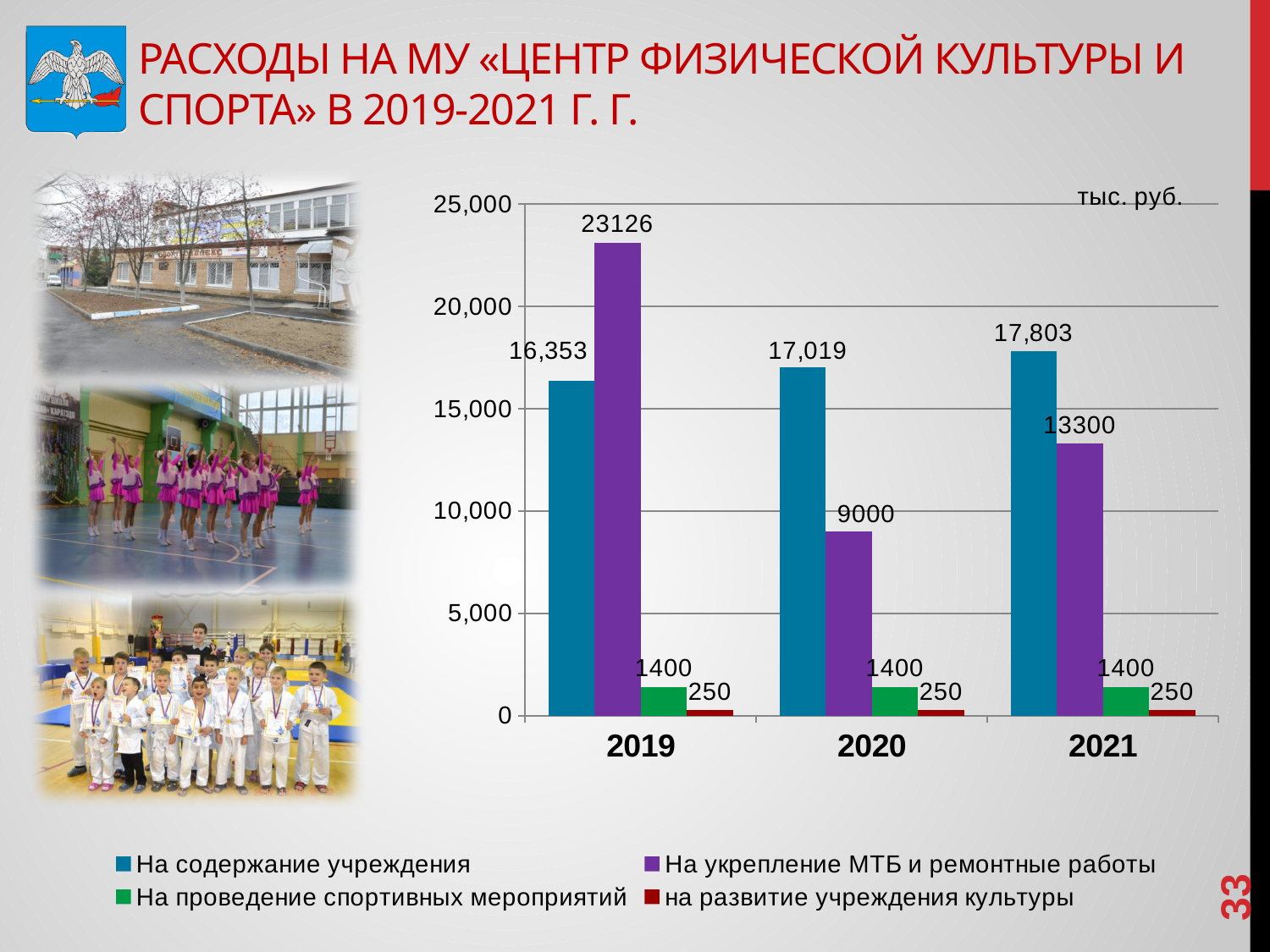
What is the value for «На содержание учреждения» in 2019? 16,353 What is the value for «На укрепление МТБ и ремонтные работы» in 2020? 9000 In which year is the value for «На содержание учреждения» lowest? 2019 Does the value for «На содержание учреждения» rise or fall from 2019 to 2021? rise How many series does the legend list? 4 What is the difference between the «На содержание учреждения» values for 2021 and 2020? 784 In which year is the value for «На укрепление МТБ и ремонтные работы» highest? 2019 What is the value for «На проведение спортивных мероприятий» in 2021? 1400 Which is larger in 2020: «На содержание учреждения» or «На укрепление МТБ и ремонтные работы»? На содержание учреждения How many years are shown on the x axis? 3 Is the value for «На укрепление МТБ и ремонтные работы» in 2019 greater or less than 20,000? greater What is the value for «На укрепление МТБ и ремонтные работы» in 2021? 13300